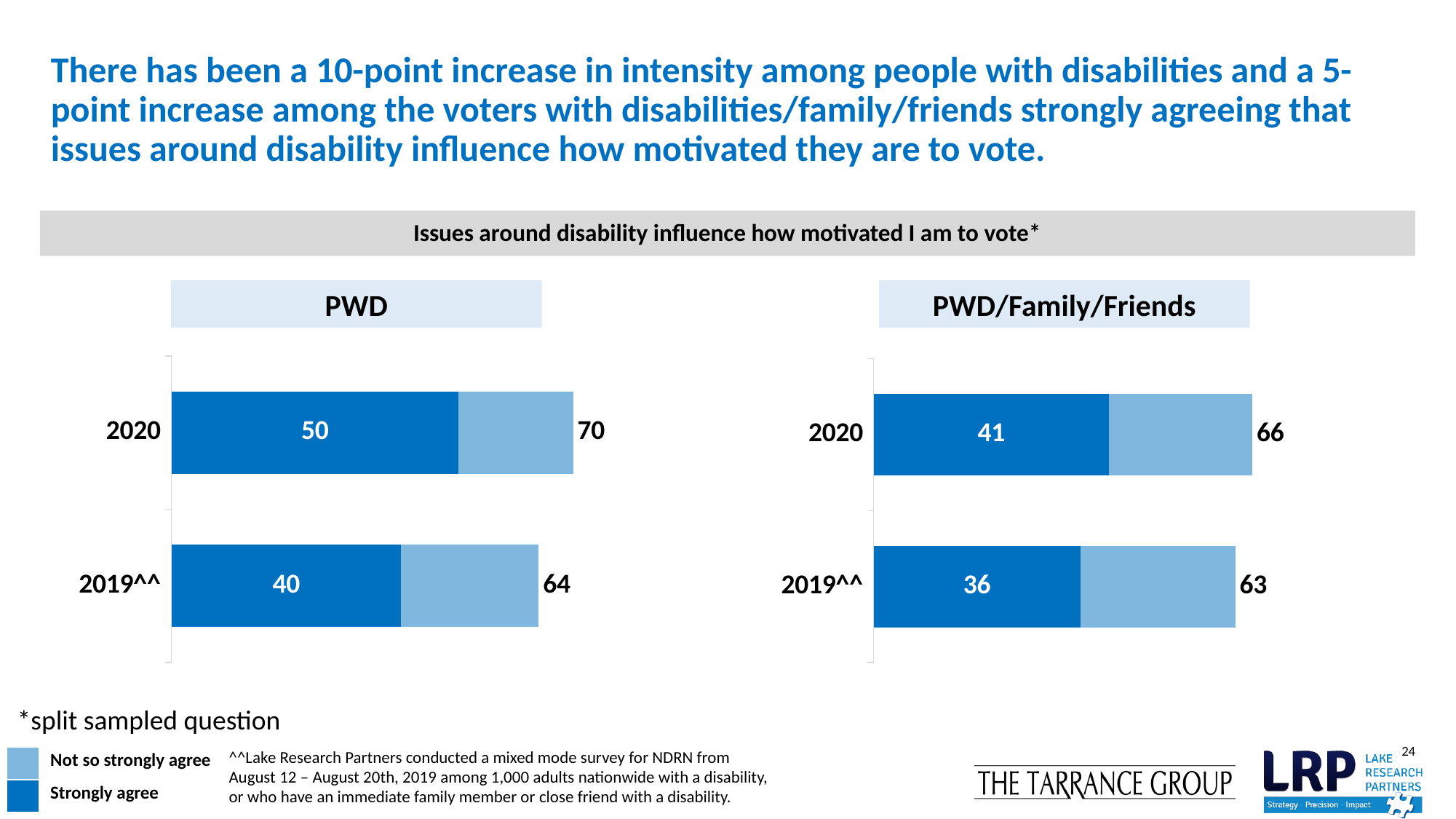
Which chart shows the higher strongly agree value for 2020, PWD or PWD/Family/Friends? PWD How many series does the legend list? 2 What type of chart is used for the PWD data? Stacked bar chart In the PWD chart, what percentage strongly agreed in 2020? 50 In the PWD/Family/Friends chart, what is the strongly agree value for 2019^^? 36 In the PWD chart, which year has the higher strongly agree value? 2020 In the PWD/Family/Friends chart, by how many points did the strongly agree value increase from 2019^^ to 2020? 5 In the PWD chart, what is the total agreement value shown for 2019^^? 64 In the PWD/Family/Friends chart, what is the total agreement value shown for 2020? 66 In the PWD chart, what is the difference between the total agreement values for 2020 and 2019^^? 6 What is the title shown above both charts? Issues around disability influence how motivated I am to vote* In the PWD chart, by how many points did the strongly agree value increase from 2019^^ to 2020? 10